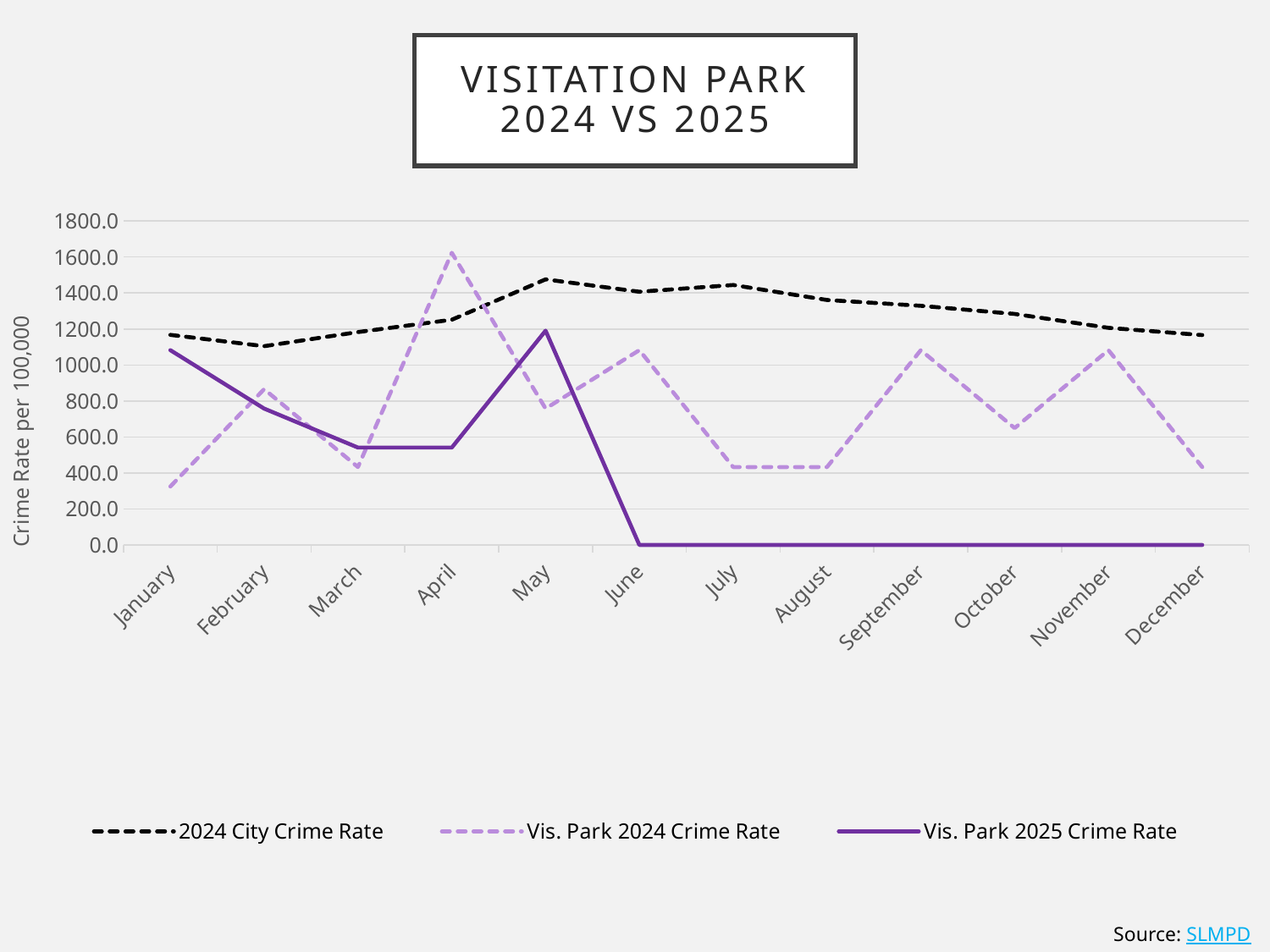
Does the Vis. Park 2025 Crime Rate rise or fall from January to March? fall What kind of chart is shown on the slide? line chart How many months are plotted along the x axis? 12 Which is larger in April: the 2024 City Crime Rate or the Vis. Park 2025 Crime Rate? 2024 City Crime Rate What is the label on the y axis? Crime Rate per 100,000 Is the Vis. Park 2024 Crime Rate for January greater or less than 400.0? less What is the Vis. Park 2025 Crime Rate value for June? 0.0 In which month does the Vis. Park 2024 Crime Rate reach its highest value? April How many series does the legend list? 3 What is the Vis. Park 2025 Crime Rate value for December? 0.0 Is the Vis. Park 2024 Crime Rate for April greater or less than 1400.0? greater In which month does the 2024 City Crime Rate reach its highest value? May